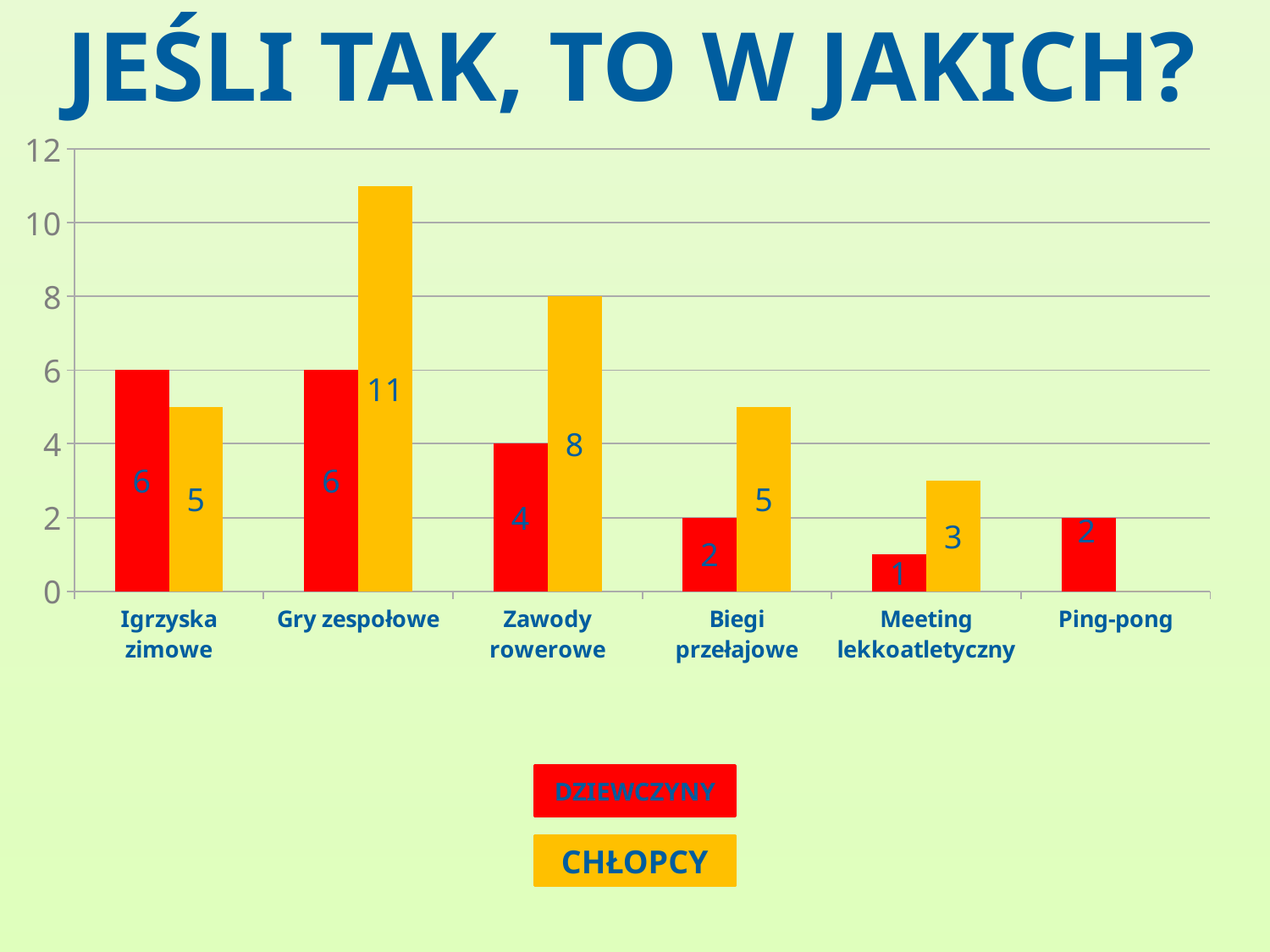
Which colour represents the DZIEWCZYNY series in the chart? red What is the value for CHŁOPCY in the Gry zespołowe category? 11 In the Igrzyska zimowe category, which series has the larger value, DZIEWCZYNY or CHŁOPCY? DZIEWCZYNY What is the difference between the CHŁOPCY and DZIEWCZYNY values in the Gry zespołowe category? 5 Which category has the lowest value for DZIEWCZYNY? Meeting lekkoatletyczny Is the value for CHŁOPCY in the Zawody rowerowe category greater or less than 6? greater What kind of chart is shown on the slide? bar chart What is the value for CHŁOPCY in the Meeting lekkoatletyczny category? 3 What is the value for DZIEWCZYNY in the Zawody rowerowe category? 4 How many categories are shown on the x axis of the chart? 6 How many series does the legend list? 2 Which category has the highest value for CHŁOPCY? Gry zespołowe